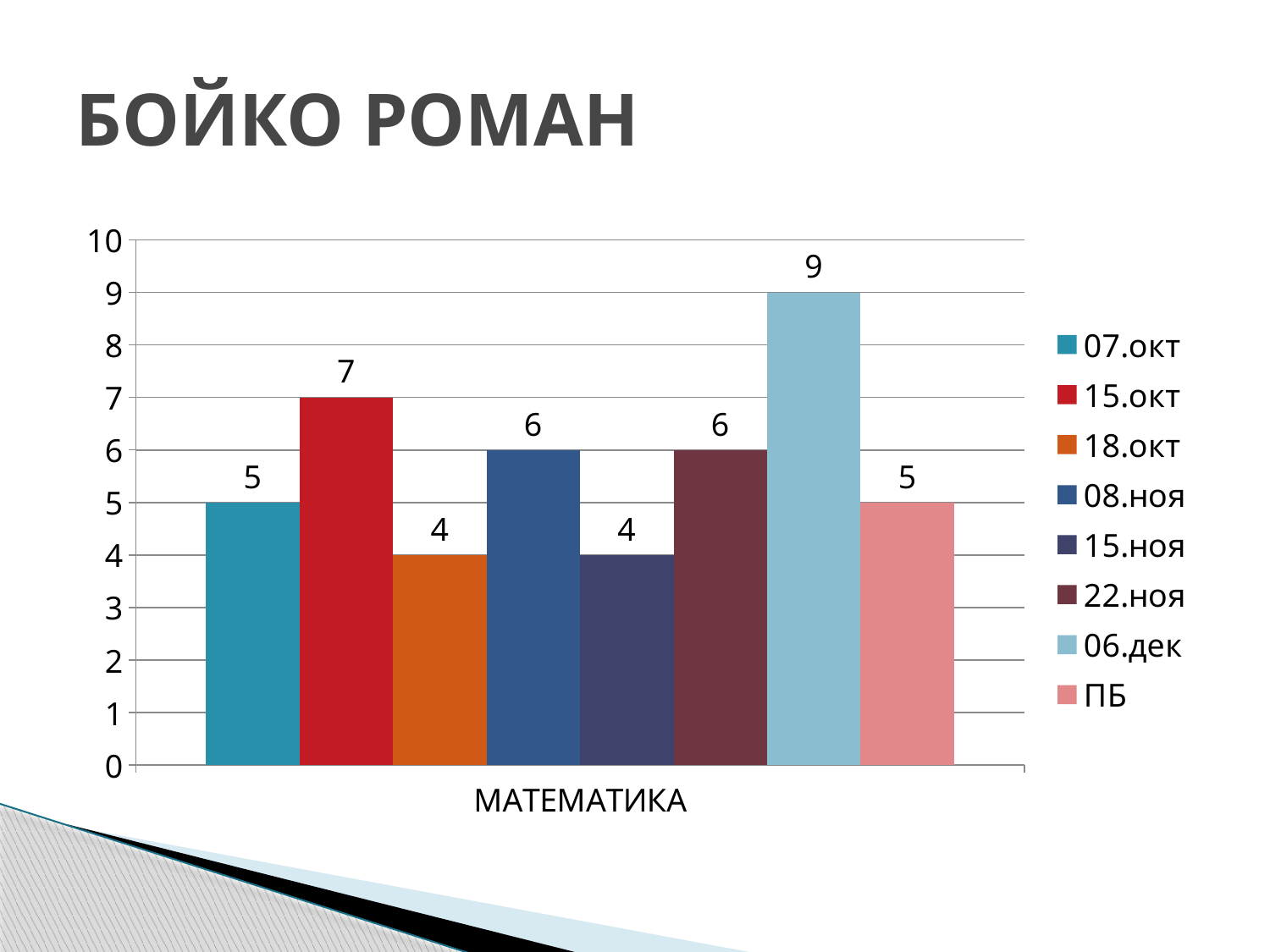
How many series does the legend list? 8 What is the value for the 06.дек series? 9 What is the value for the 15.окт series? 7 What is the difference between the 06.дек value and the 15.окт value? 2 What is the value for the ПБ series? 5 What kind of chart is shown on the slide? bar chart Is the value for 06.дек greater or less than 8? greater Which is larger, the value for 08.ноя or the value for 15.ноя? 08.ноя Which series has the highest value? 06.дек What is the value for the 07.окт series in the МАТЕМАТИКА category? 5 What is the category label on the x axis? МАТЕМАТИКА What is the title of the slide? БОЙКО РОМАН